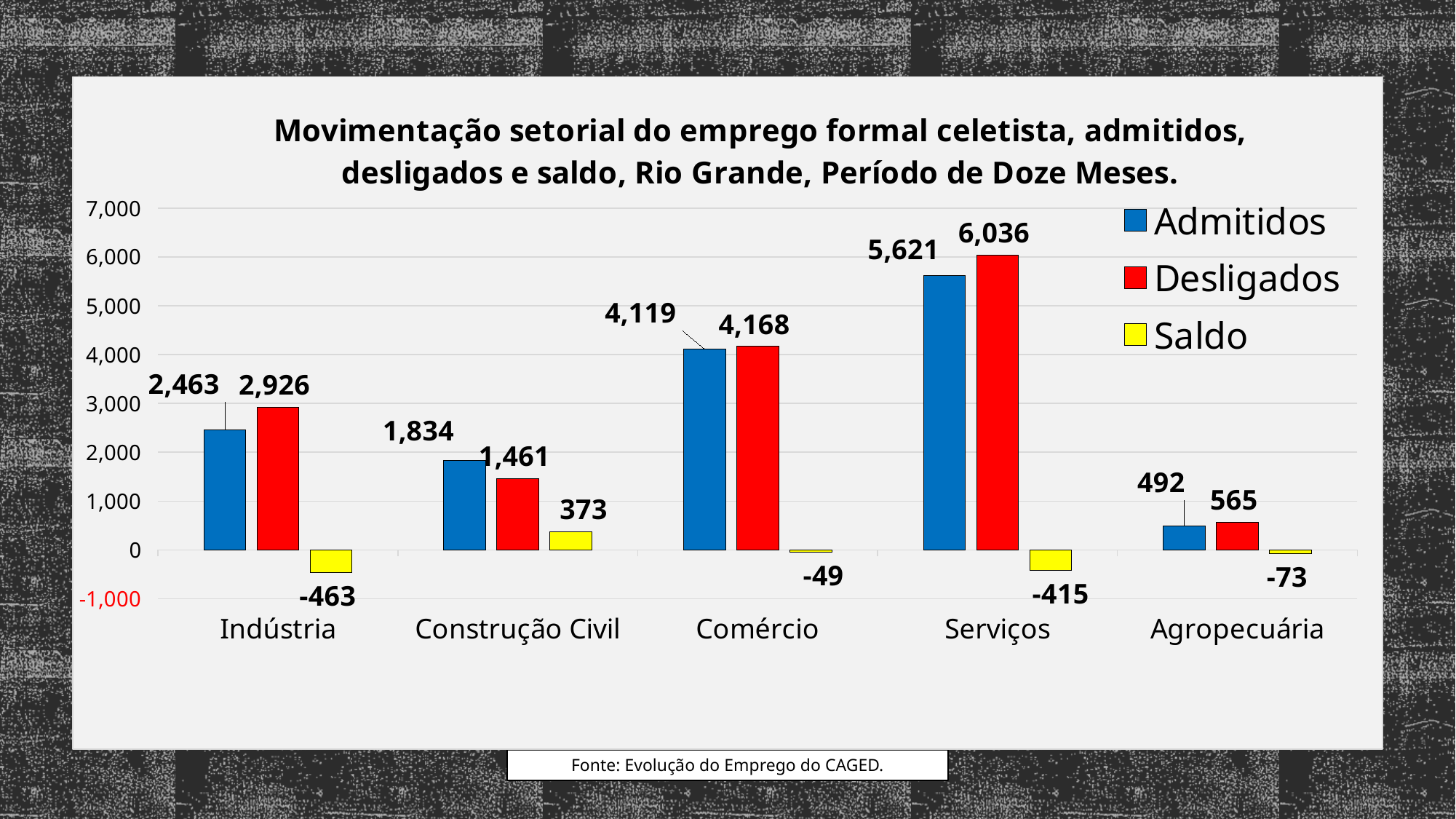
How many series does the legend list? 3 What is the Saldo value for Construção Civil? 373 Which is larger for Construção Civil, Admitidos or Desligados? Admitidos What kind of chart is shown on the slide? Bar chart What is the Saldo value for Comércio? -49 Which sector has the highest Desligados value? Serviços What is the Admitidos value for Serviços? 5,621 How many sectors are shown on the x axis? 5 Which colour represents the Saldo series? Yellow Which sector has the lowest Admitidos value? Agropecuária What is the difference between Desligados and Admitidos for Serviços? 415 What is the Desligados value for Indústria? 2,926